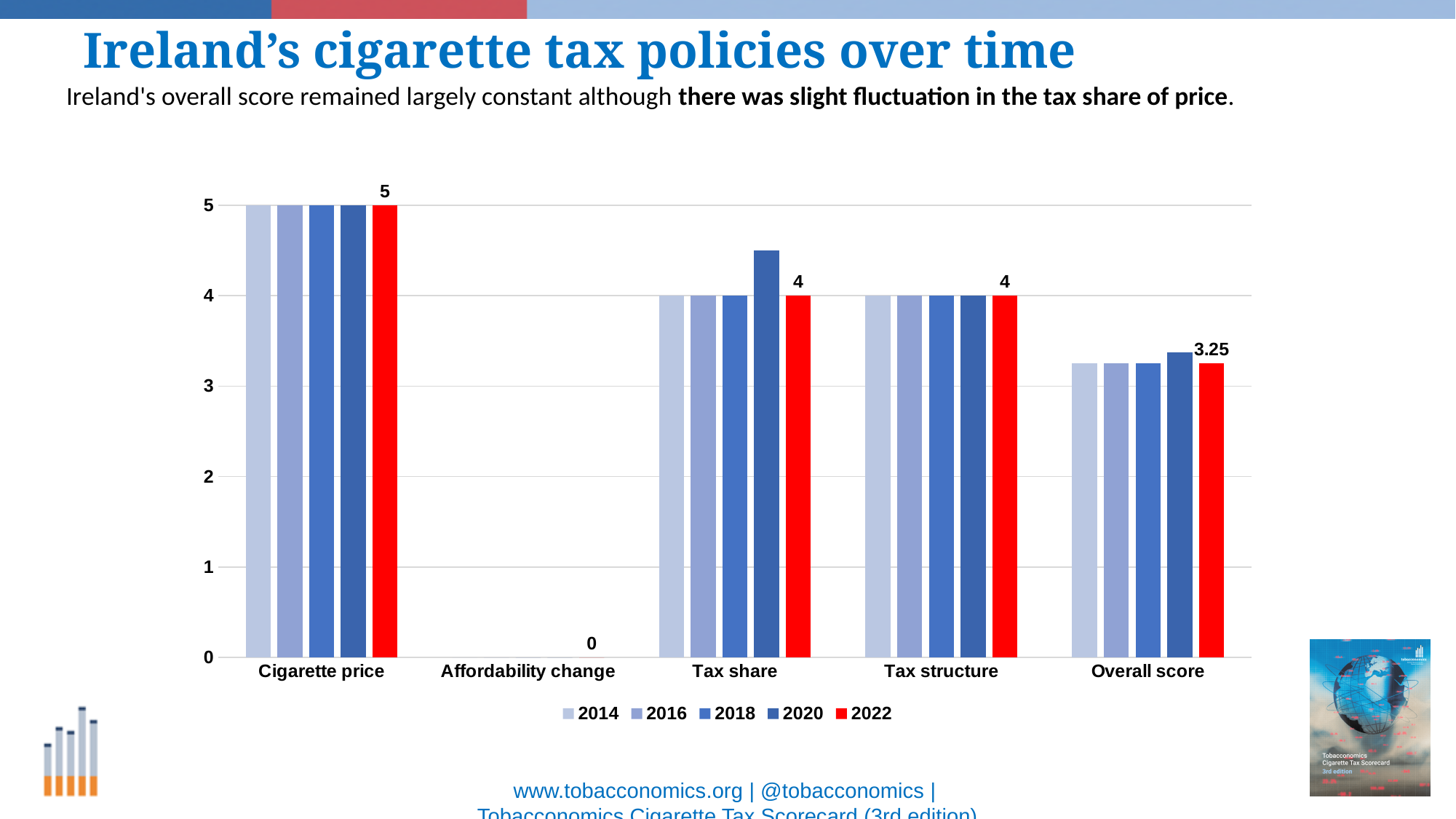
Is the 2020 value for Tax share greater or less than 4? greater Which category has the lowest 2022 value? Affordability change What is the 2022 value for Affordability change? 0 Which is larger in 2022: Tax structure or Overall score? Tax structure What is the 2022 value for Overall score? 3.25 Which category has the highest 2022 value? Cigarette price What is the 2022 value for Cigarette price? 5 How many categories are shown on the x axis? 5 What kind of chart is shown on the slide? bar chart What is the difference between the 2022 values for Cigarette price and Tax share? 1 How many series does the legend list? 5 What is the 2022 value for Tax share? 4